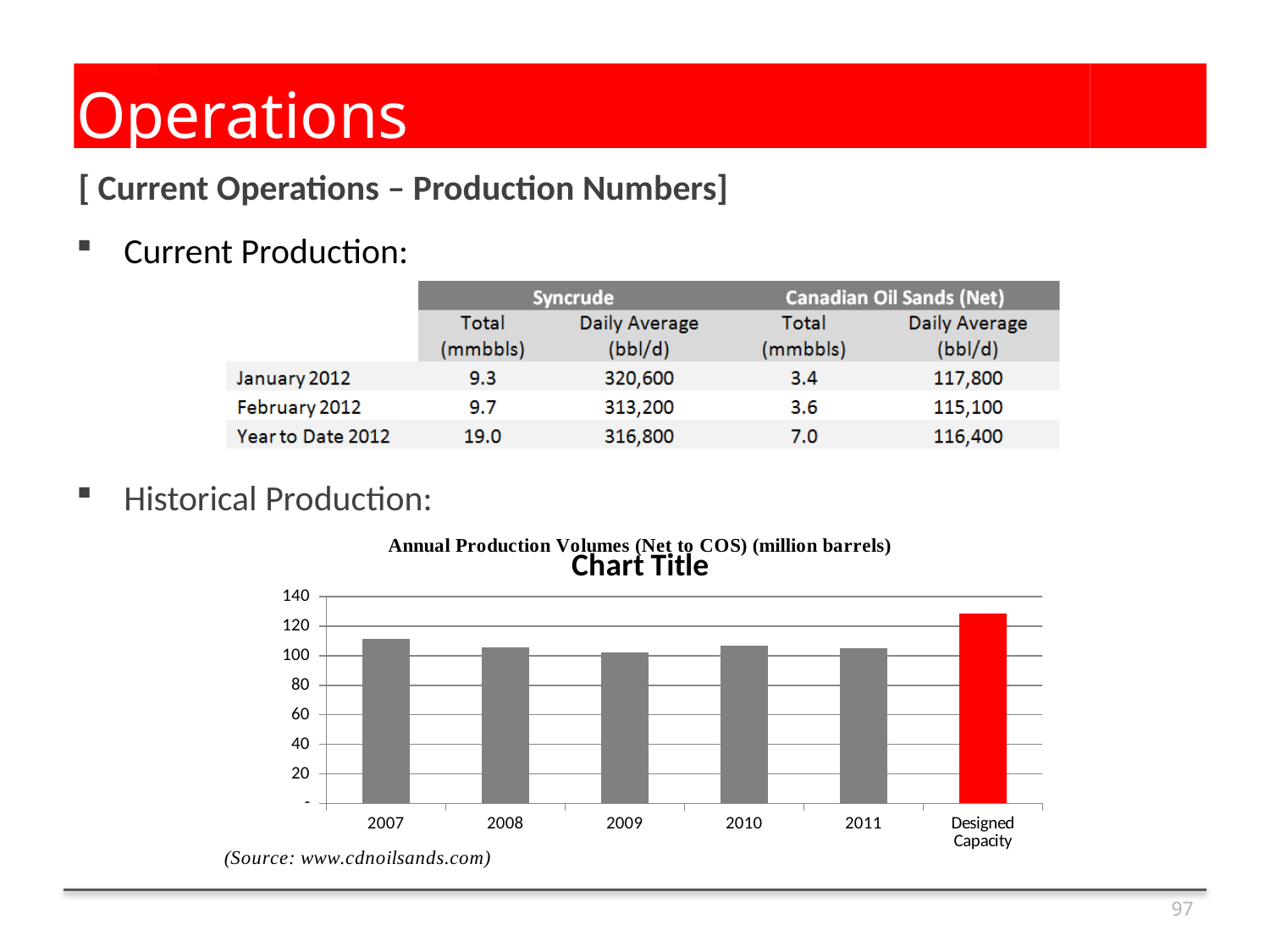
Is the value for 2010 greater or less than 80? greater Is the value for 2009 greater or less than 120? less Is the value for 2011 greater or less than 120? less Which is larger, the value for 2007 or the value for 2009? 2007 What is the highest value shown on the y axis of the Annual Production Volumes chart? 140 How many categories are shown on the x axis of the Annual Production Volumes chart? 6 What kind of chart is shown under Historical Production? bar chart Which is larger, the value for 2007 or the value for Designed Capacity? Designed Capacity Which category has the highest bar in the Annual Production Volumes chart? Designed Capacity What colour is the Designed Capacity bar in the chart? red